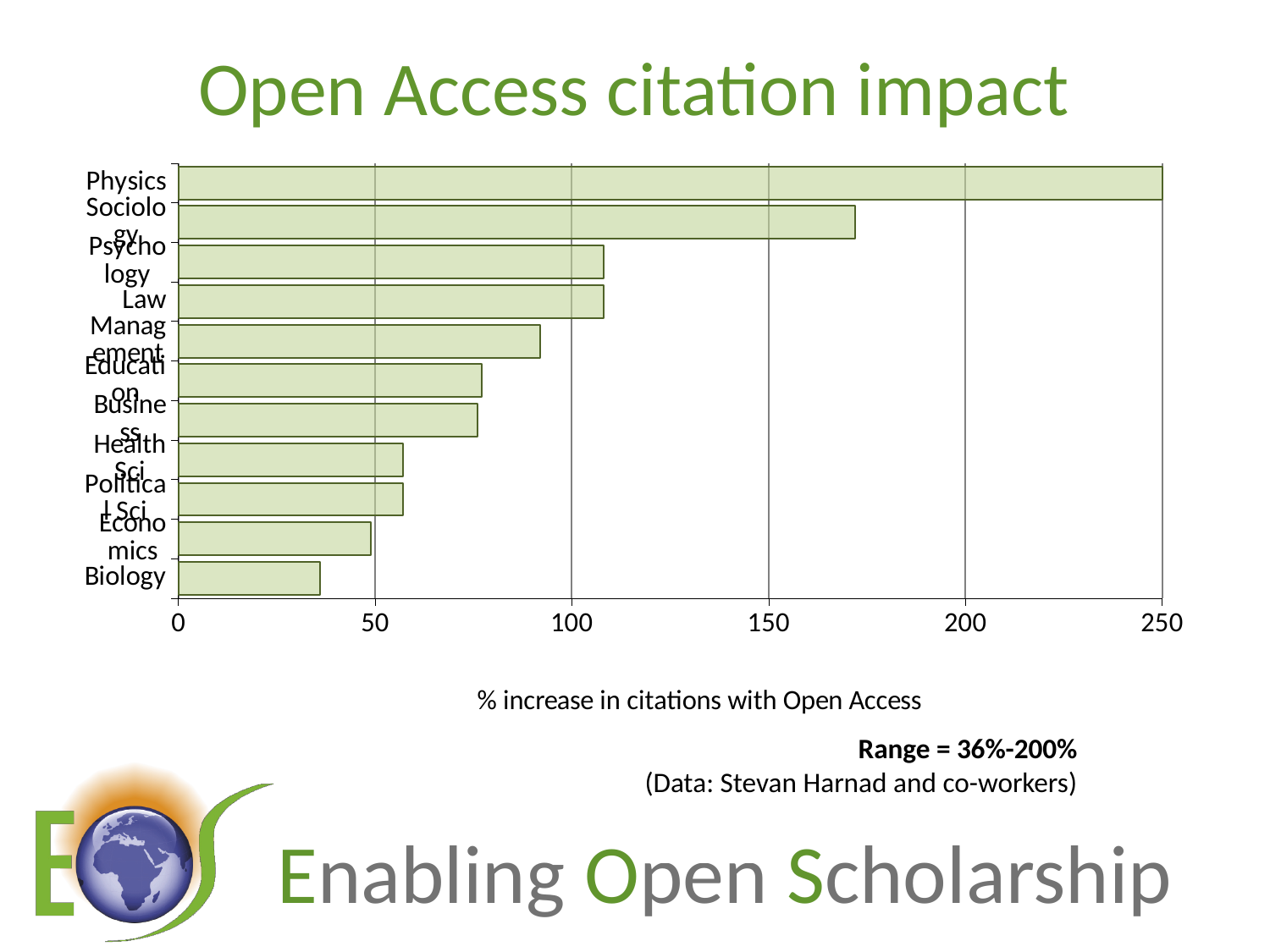
Which category has the lowest % increase in citations with Open Access? Biology What is the title of the chart on the slide? Open Access citation impact Which has a larger value, Business or Economics? Business Is the value for Sociology greater or less than 150? greater Which category has the highest % increase in citations with Open Access? Physics Which has a larger value, Sociology or Psychology? Sociology Is the value for Management greater or less than 100? less Is the value for Biology greater or less than 50? less What type of chart is shown on the slide? bar chart How many categories are plotted in the chart? 11